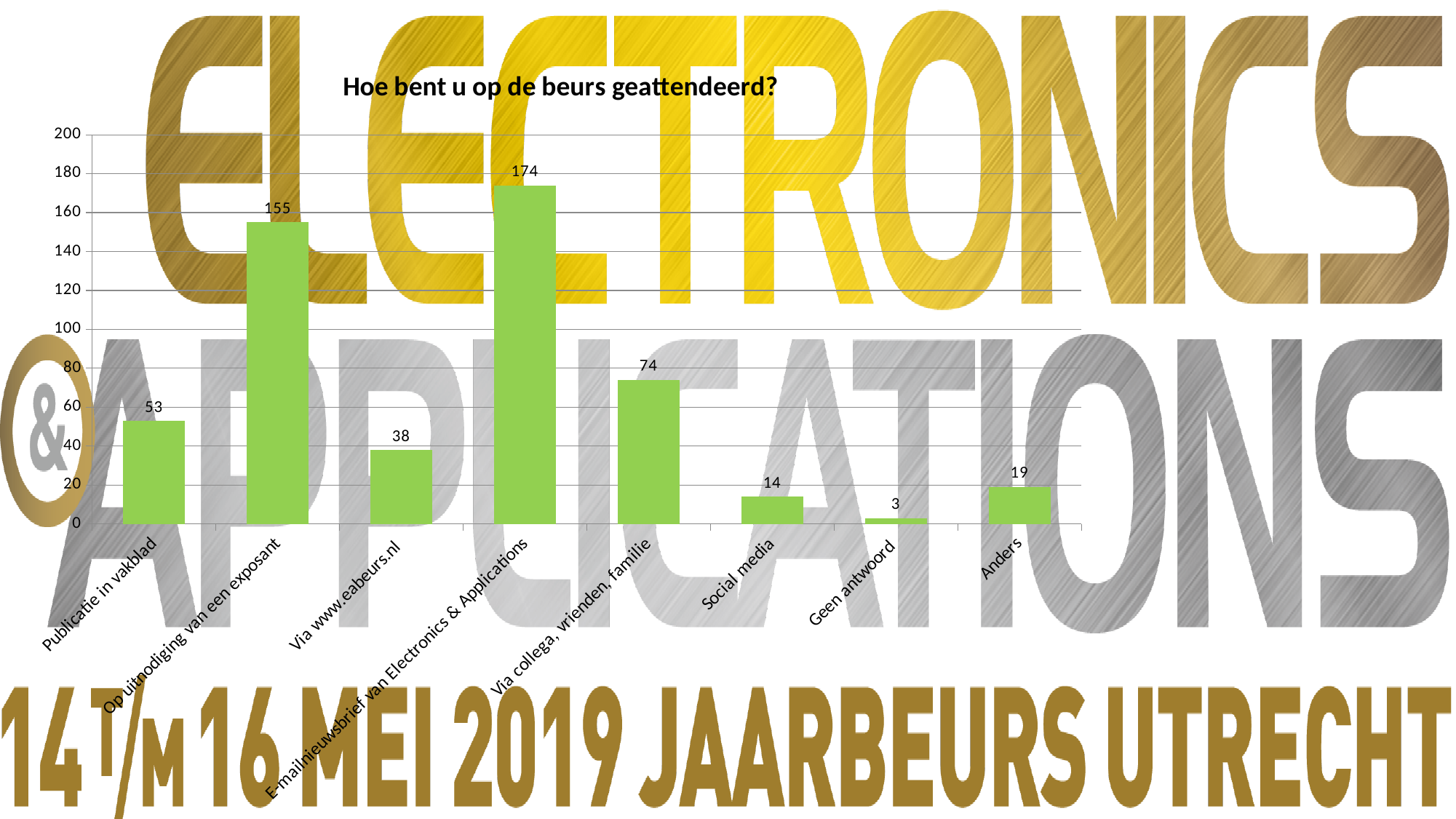
What is the value for 'E-mailnieuwsbrief van Electronics & Applications'? 174 Which is larger, 'Anders' or 'Social media'? Anders What is the title of the chart? Hoe bent u op de beurs geattendeerd? How many categories are shown in the chart? 8 What is the difference between 'E-mailnieuwsbrief van Electronics & Applications' and 'Op uitnodiging van een exposant'? 19 Which category has the lowest value? Geen antwoord Which category has the highest value? E-mailnieuwsbrief van Electronics & Applications What is the value for 'Social media'? 14 What is the value for 'Publicatie in vakblad'? 53 What kind of chart is shown on the slide? bar chart Is the value for 'Op uitnodiging van een exposant' greater or less than 140? greater What is the difference between 'Via collega, vrienden, familie' and 'Via www.eabeurs.nl'? 36